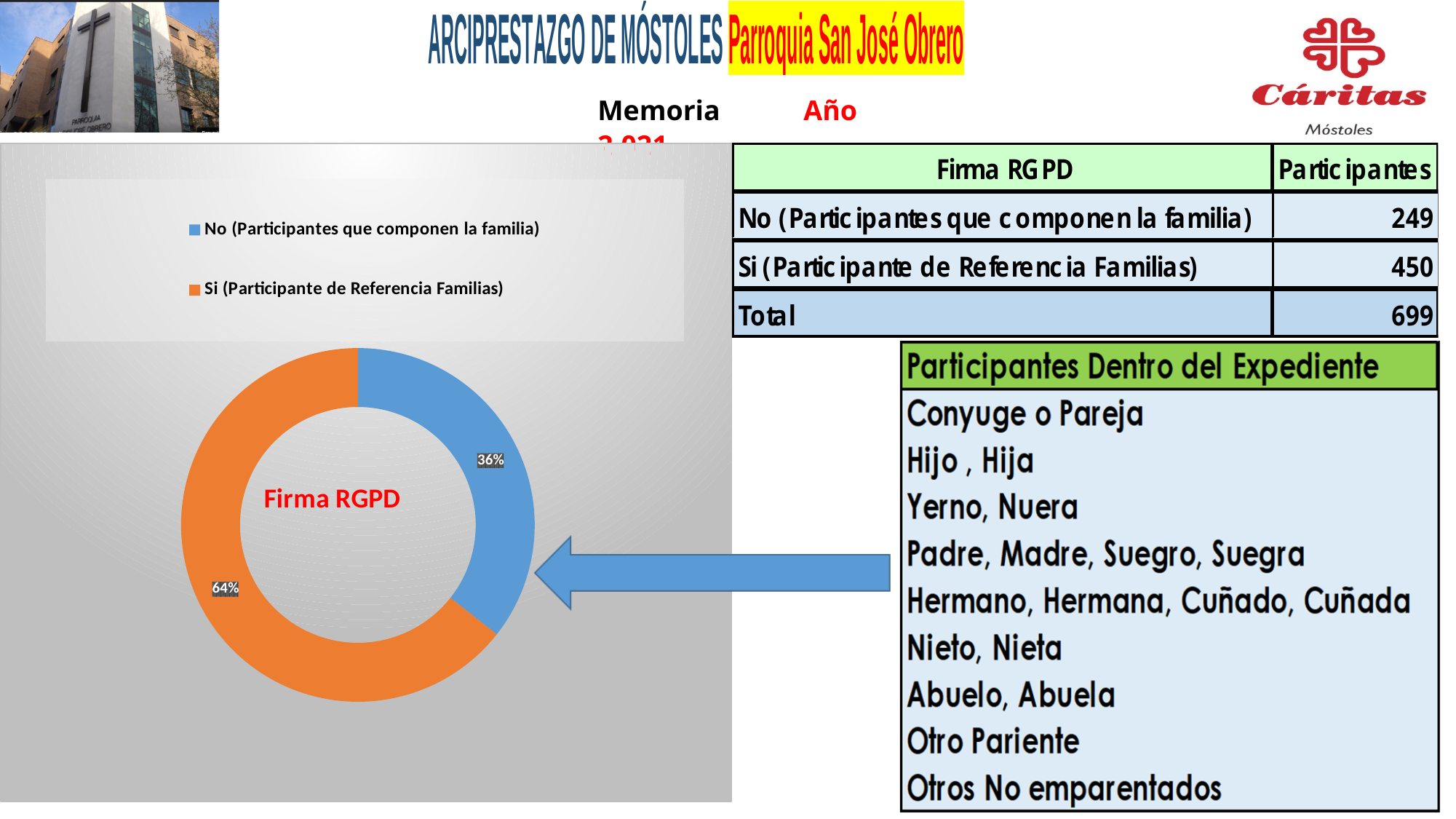
Which is larger in the chart: the share for "Si" or the share for "No"? Si (Participante de Referencia Familias) What percentage does the chart show for "No (Participantes que componen la familia)"? 36% What kind of chart is used to show the Firma RGPD data? Doughnut (pie) chart Which category has the largest share in the Firma RGPD chart? Si (Participante de Referencia Familias) How many categories (slices) does the Firma RGPD chart have? 2 What colour represents "Si (Participante de Referencia Familias)" in the chart? Orange By how many percentage points does the "Si" share exceed the "No" share in the chart? 28 percentage points What title is shown in the centre of the doughnut chart? Firma RGPD Is the share for "No (Participantes que componen la familia)" greater or less than 50%? less Which category has the smallest share in the Firma RGPD chart? No (Participantes que componen la familia) How many entries does the legend of the chart list? 2 What percentage does the chart show for "Si (Participante de Referencia Familias)"? 64%